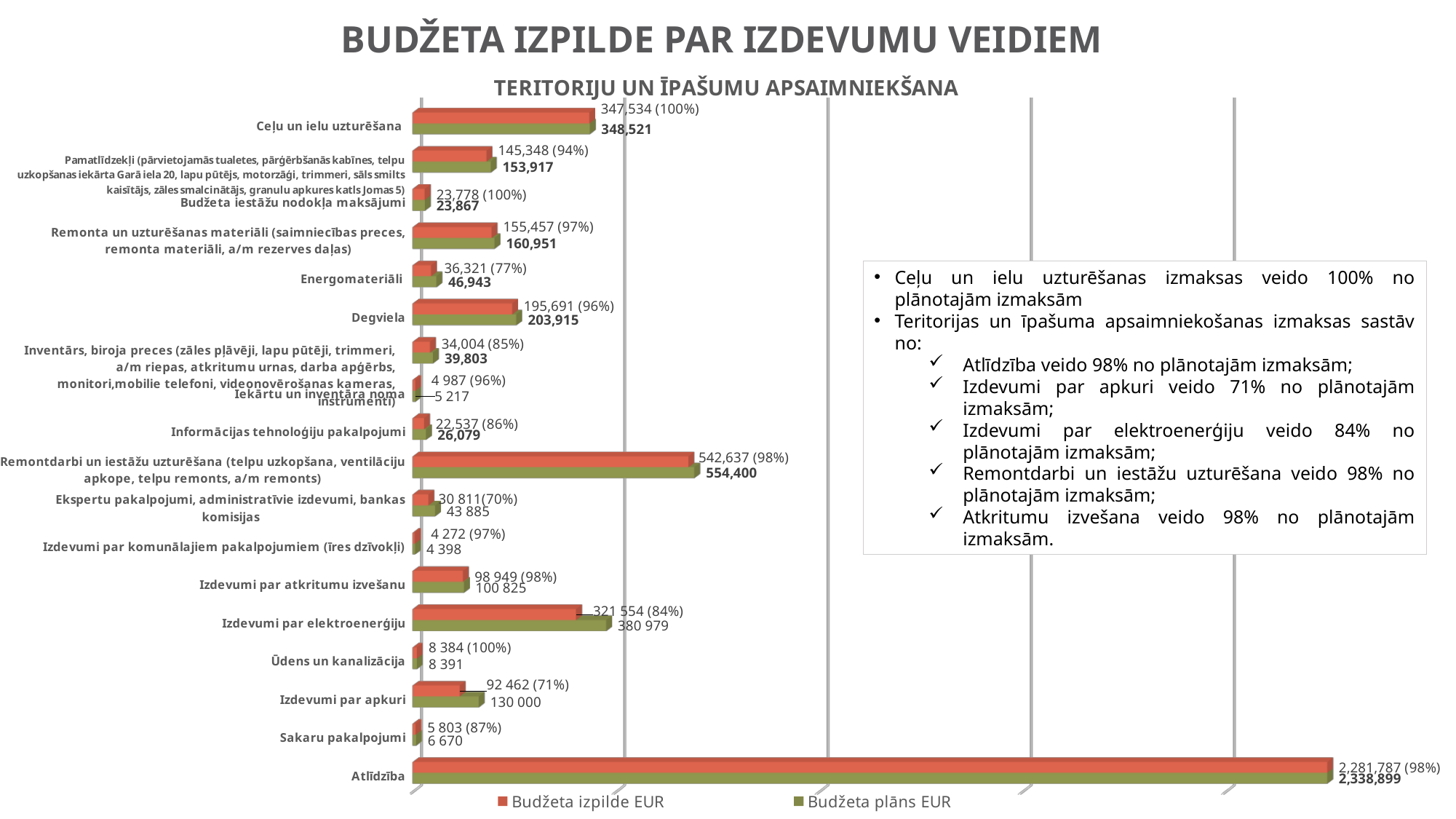
What is the title of the chart? TERITORIJU UN ĪPAŠUMU APSAIMNIEKŠANA Which category has the lowest Budžeta izpilde EUR value? Izdevumi par komunālajiem pakalpojumiem (īres dzīvokļi) How many series does the legend list? 2 What percentage of the plan was executed for Energomateriāli? 77% Which has the larger Budžeta izpilde EUR value, Ceļu un ielu uzturēšana or Izdevumi par elektroenerģiju? Ceļu un ielu uzturēšana What type of chart is shown on the slide? bar chart What is the Budžeta izpilde EUR value for Degviela? 195,691 What is the difference between the Budžeta plāns EUR and Budžeta izpilde EUR values for Izdevumi par apkuri? 37 538 What is the Budžeta plāns EUR value for Ūdens un kanalizācija? 8 391 Which category has the highest Budžeta izpilde EUR value? Atlīdzība What is the Budžeta plāns EUR value for Degviela? 203,915 What are the two series named in the legend? Budžeta izpilde EUR and Budžeta plāns EUR